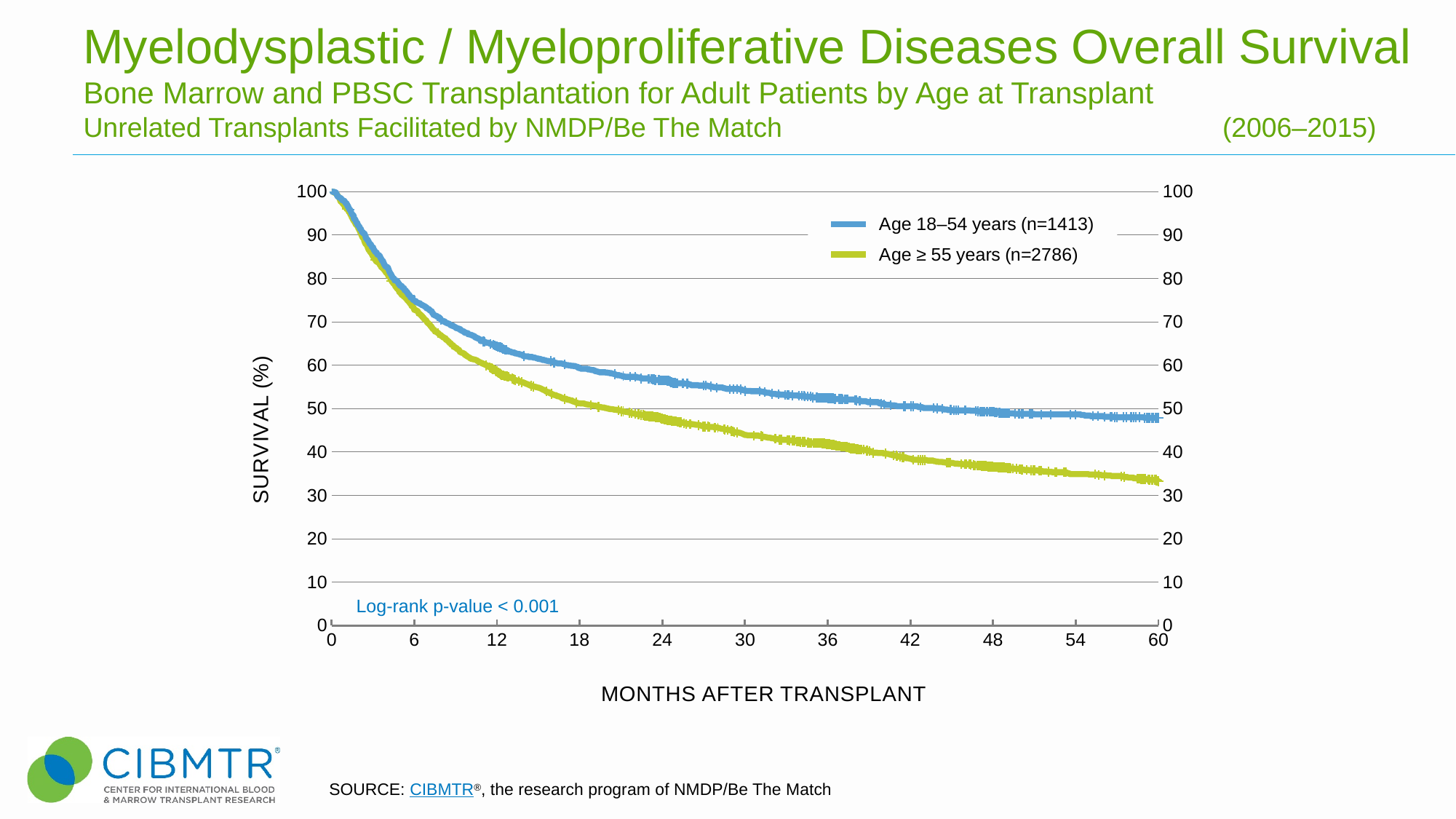
At 60 months after transplant, which age group has the higher survival? Age 18–54 years Do the survival curves rise or fall as months after transplant increase? fall How many series does the legend list? 2 What kind of chart is shown on the slide? line chart Is the survival for Age ≥ 55 years at 60 months greater or less than 30? greater Is the survival for Age 18–54 years at 12 months greater or less than 60? greater What is the survival (%) for both age groups at 0 months after transplant? 100 Is the survival for Age ≥ 55 years at 60 months greater or less than 40? less What log-rank p-value is shown on the chart? < 0.001 How many patients (n) are in the Age ≥ 55 years group according to the legend? 2786